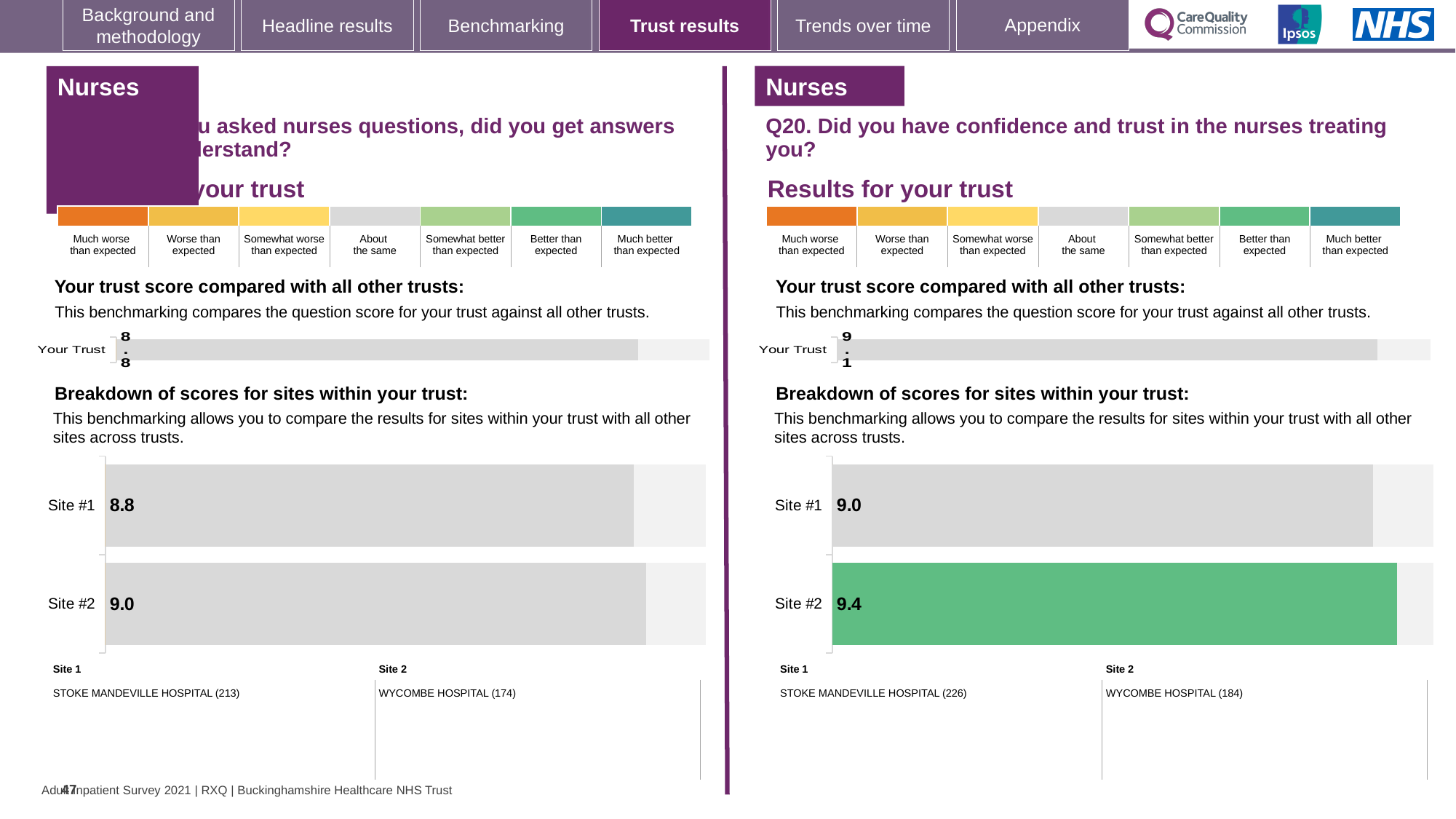
On the left-hand slide, what is the score for Site #1 in the breakdown of scores for sites within your trust? 8.8 On the right-hand slide (Q20), what is the difference between the Site #2 score and the Site #1 score? 0.4 On the left-hand slide, what is the 'Your Trust' score in the chart comparing your trust with all other trusts? 8.8 On the right-hand slide (Q20, confidence and trust in nurses), what is the score for Site #1 in the breakdown of scores for sites within your trust? 9.0 On the right-hand slide (Q20), what is the 'Your Trust' score in the chart comparing your trust with all other trusts? 9.1 On the right-hand slide (Q20), what is the score for Site #2 in the breakdown of scores for sites within your trust? 9.4 On the left-hand slide, what is the difference between the Site #2 score and the Site #1 score? 0.2 On the left-hand slide, which site has the lower score in the breakdown of sites within your trust? Site #1 On the right-hand slide (Q20), which site has the higher score in the breakdown of sites within your trust? Site #2 What type of chart is used for the breakdown of scores for sites within your trust on the right-hand slide (Q20)? Bar chart On the left-hand slide, what is the score for Site #2 in the breakdown of scores for sites within your trust? 9.0 How many sites are shown in the breakdown chart on the right-hand slide (Q20)? 2